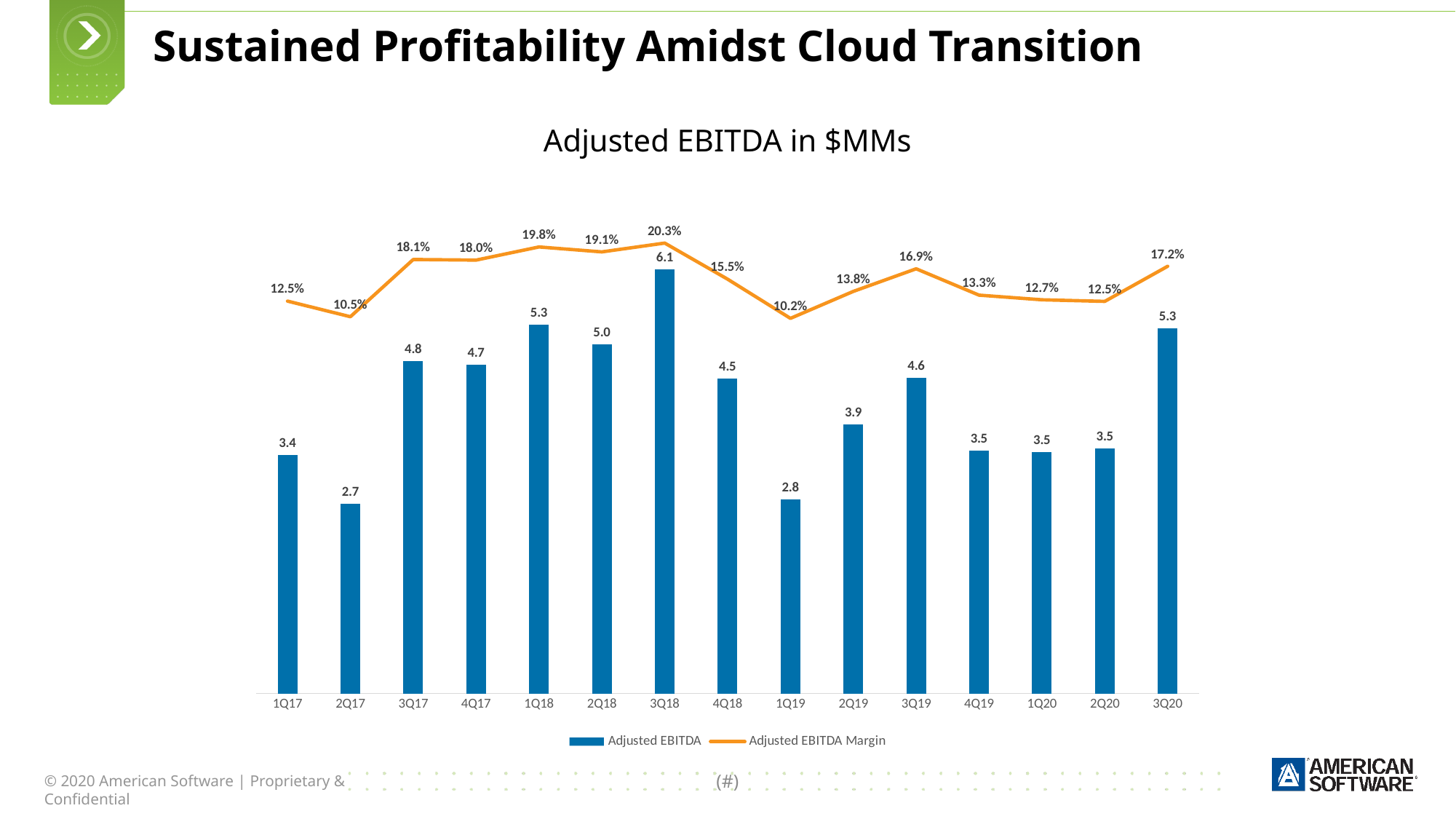
What is the Adjusted EBITDA Margin for 1Q19? 10.2% What kind of chart is used to show Adjusted EBITDA? Bar chart What is the Adjusted EBITDA for 2Q17? 2.7 What is the difference in Adjusted EBITDA between 3Q18 and 1Q19? 3.3 Which quarter has the highest Adjusted EBITDA? 3Q18 Which quarter has the lowest Adjusted EBITDA Margin? 1Q19 What is the Adjusted EBITDA Margin for 3Q20? 17.2% How many series does the legend list? 2 What is the title of the chart? Adjusted EBITDA in $MMs How many quarters are shown on the x axis? 15 What is the Adjusted EBITDA for 3Q18? 6.1 Which is larger, the Adjusted EBITDA for 3Q19 or for 2Q19? 3Q19